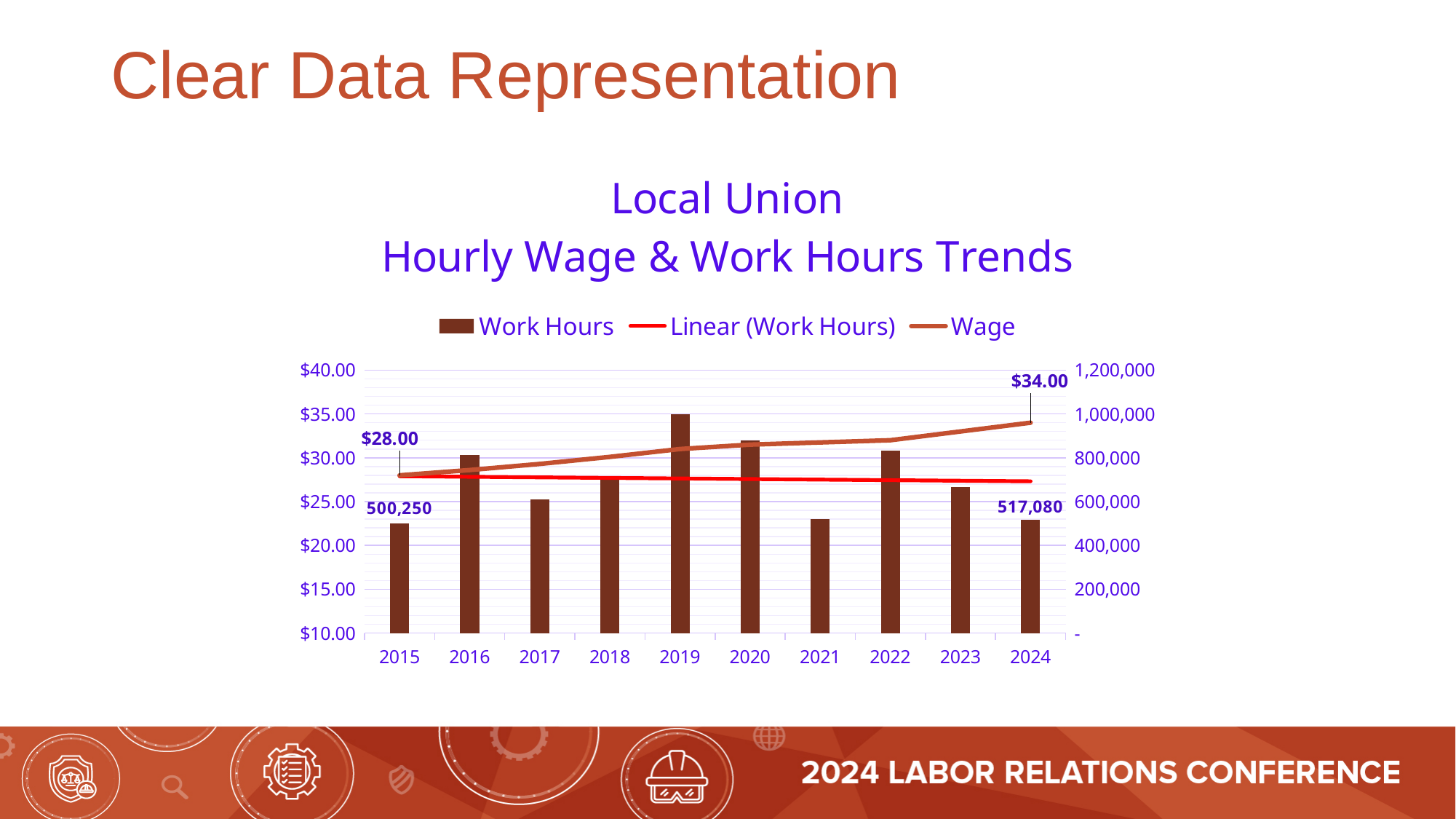
Which year has the larger Work Hours bar, 2016 or 2017? 2016 What is the difference between the Work Hours in 2024 and in 2015? 16,830 Is the Work Hours value for 2017 greater or less than 800,000? less What is the Work Hours value labelled for 2024? 517,080 How many years are shown on the x axis? 10 Is the Work Hours value for 2019 greater or less than 800,000? greater By how much did the Wage increase from 2015 to 2024? $6.00 How many series does the legend list? 3 What is the Work Hours value labelled for 2015? 500,250 Which year has the highest Work Hours bar? 2019 What is the Wage value shown for 2024? $34.00 What is the Wage value shown for 2015? $28.00